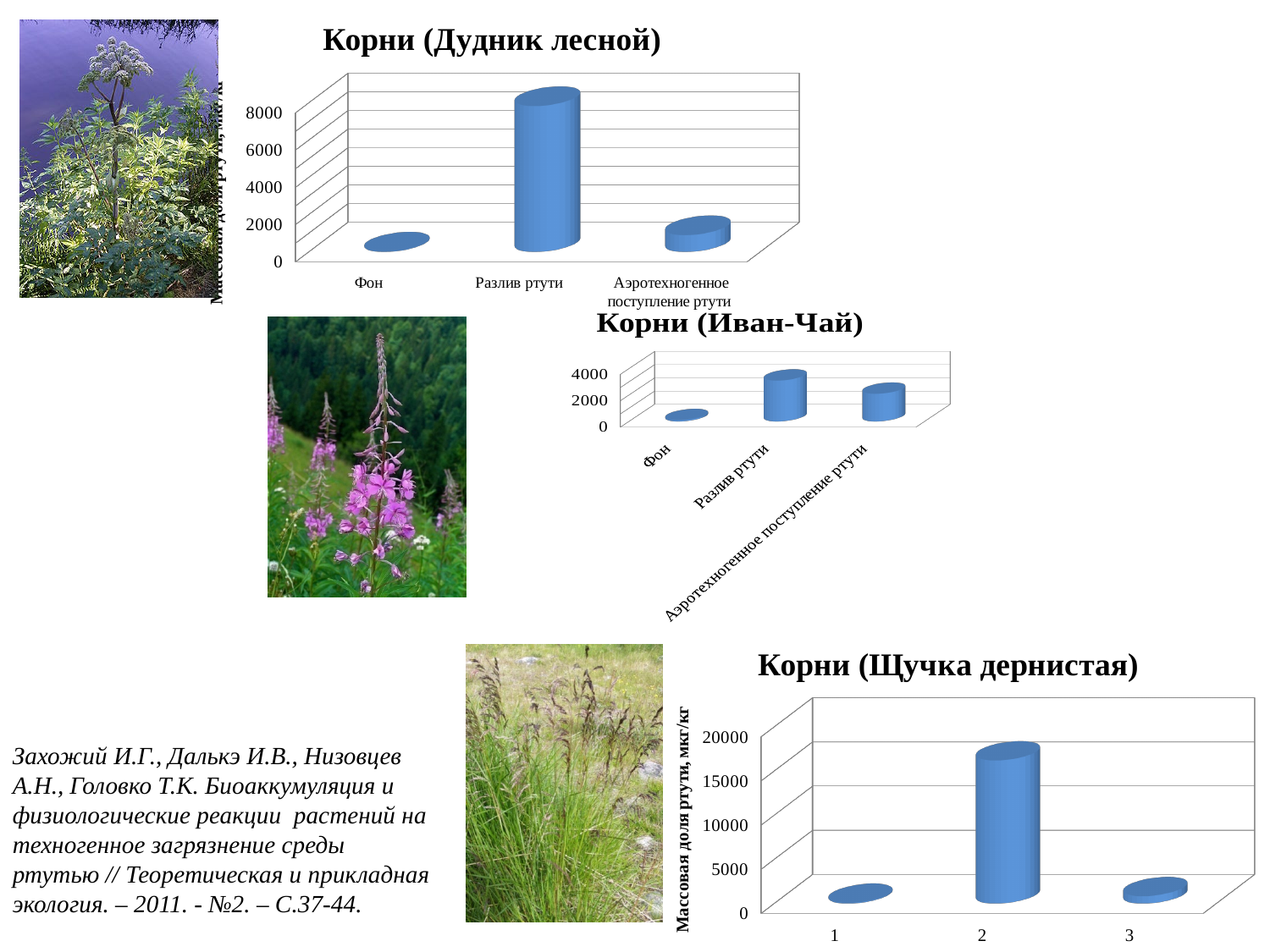
In the chart 'Корни (Щучка дернистая)', which category has the highest value? 2 What is the y-axis label of the chart 'Корни (Щучка дернистая)'? Массовая доля ртути, мкг/кг In the chart 'Корни (Иван-Чай)', is the value for Разлив ртути greater or less than 2000? greater In the chart 'Корни (Дудник лесной)', which category has the highest value? Разлив ртути In the chart 'Корни (Дудник лесной)', is the value for Разлив ртути greater or less than 6000? greater In the chart 'Корни (Иван-Чай)', which is larger, the value for Фон or the value for Аэротехногенное поступление ртути? Аэротехногенное поступление ртути What kind of chart is 'Корни (Дудник лесной)'? bar chart In the chart 'Корни (Щучка дернистая)', is the value for category 2 greater or less than 10000? greater In the chart 'Корни (Иван-Чай)', which category has the highest value? Разлив ртути How many categories are shown in the chart 'Корни (Иван-Чай)'? 3 In the chart 'Корни (Дудник лесной)', which category has the lowest value? Фон